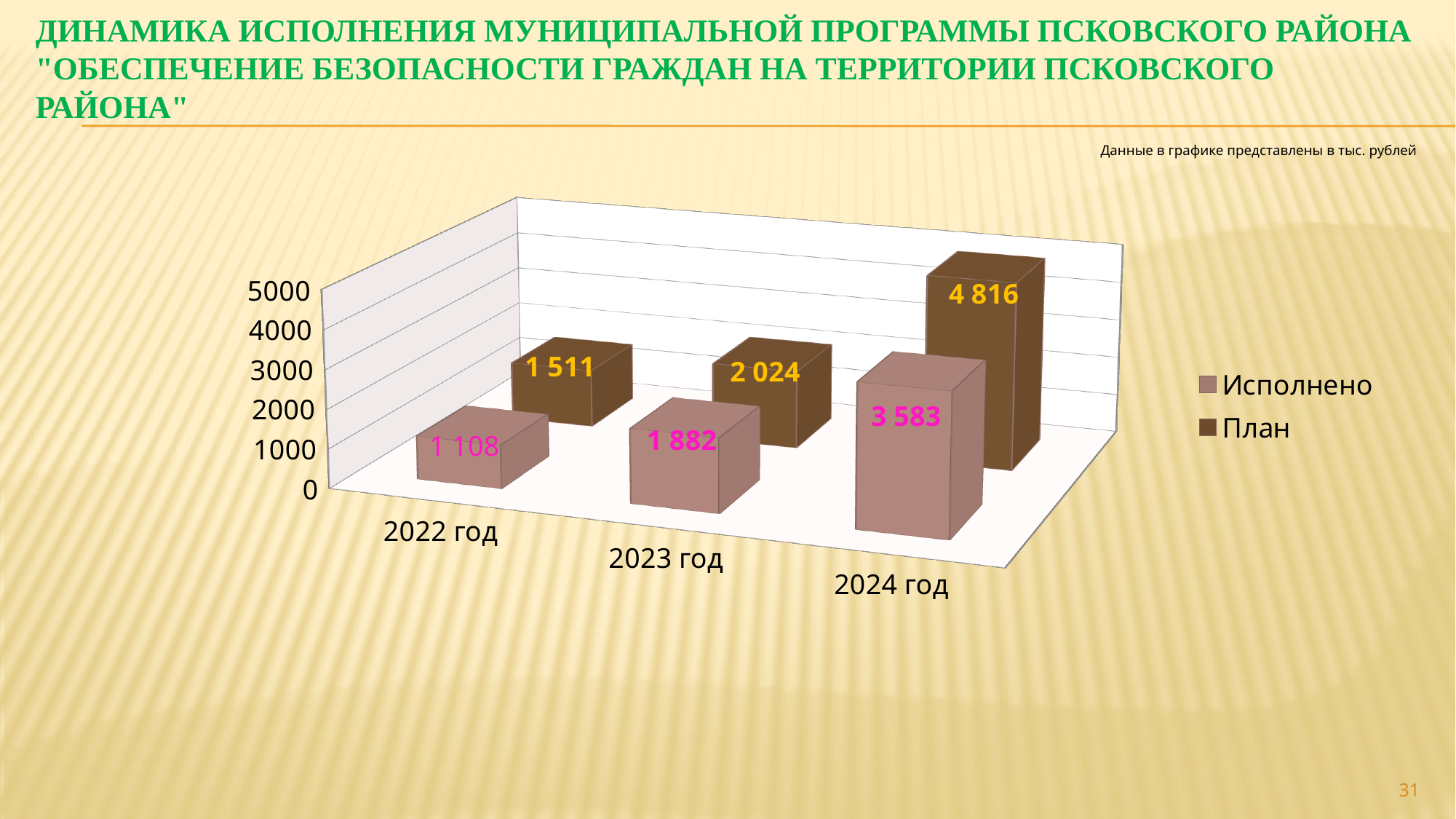
Do the Исполнено values rise or fall from 2022 год to 2024 год? Rise What is the value of Исполнено for 2022 год? 1 108 What is the value of План for 2023 год? 2 024 Which year has the highest Исполнено value? 2024 год Which is larger: План for 2023 год or Исполнено for 2024 год? Исполнено for 2024 год What is the difference between План and Исполнено for 2024 год? 1 233 What is the difference between Исполнено for 2023 год and Исполнено for 2022 год? 774 How many series does the legend list? 2 How many years are shown on the x axis? 3 What is the value of План for 2024 год? 4 816 Which year has the lowest План value? 2022 год What kind of chart is shown on the slide? Bar chart